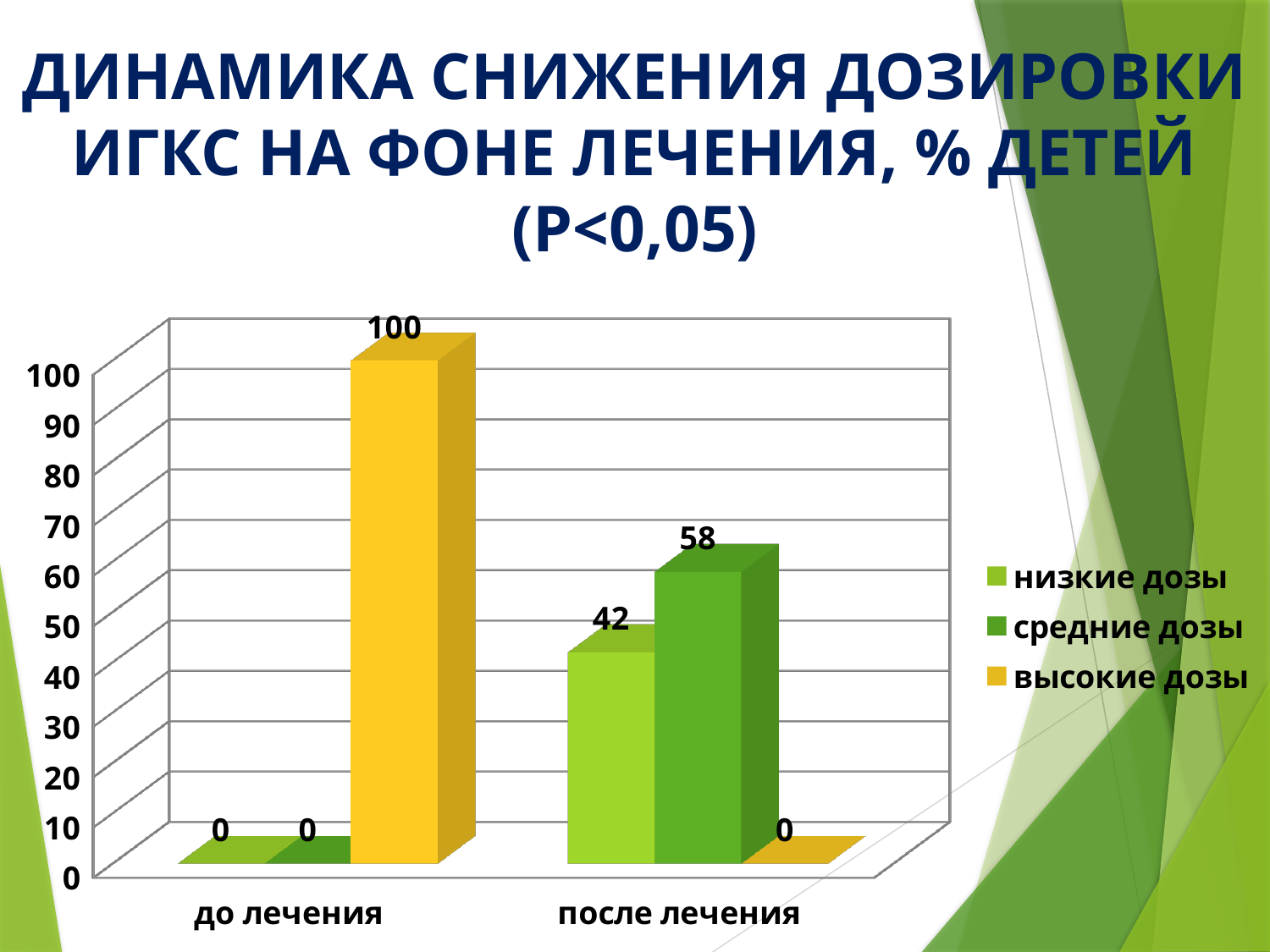
What is the difference between средние дозы and низкие дозы in the после лечения category? 16 How many categories are shown on the x axis? 2 What is the value for высокие дозы in the до лечения category? 100 What kind of chart is shown on the slide? bar chart What is the value for низкие дозы in the после лечения category? 42 What is the value for средние дозы in the после лечения category? 58 What colour are the bars for высокие дозы? yellow Which series has the highest value in the после лечения category? средние дозы What is the value for высокие дозы in the после лечения category? 0 Does the value for высокие дозы rise or fall from до лечения to после лечения? fall Which is larger in the после лечения category: низкие дозы or средние дозы? средние дозы How many series does the legend list? 3